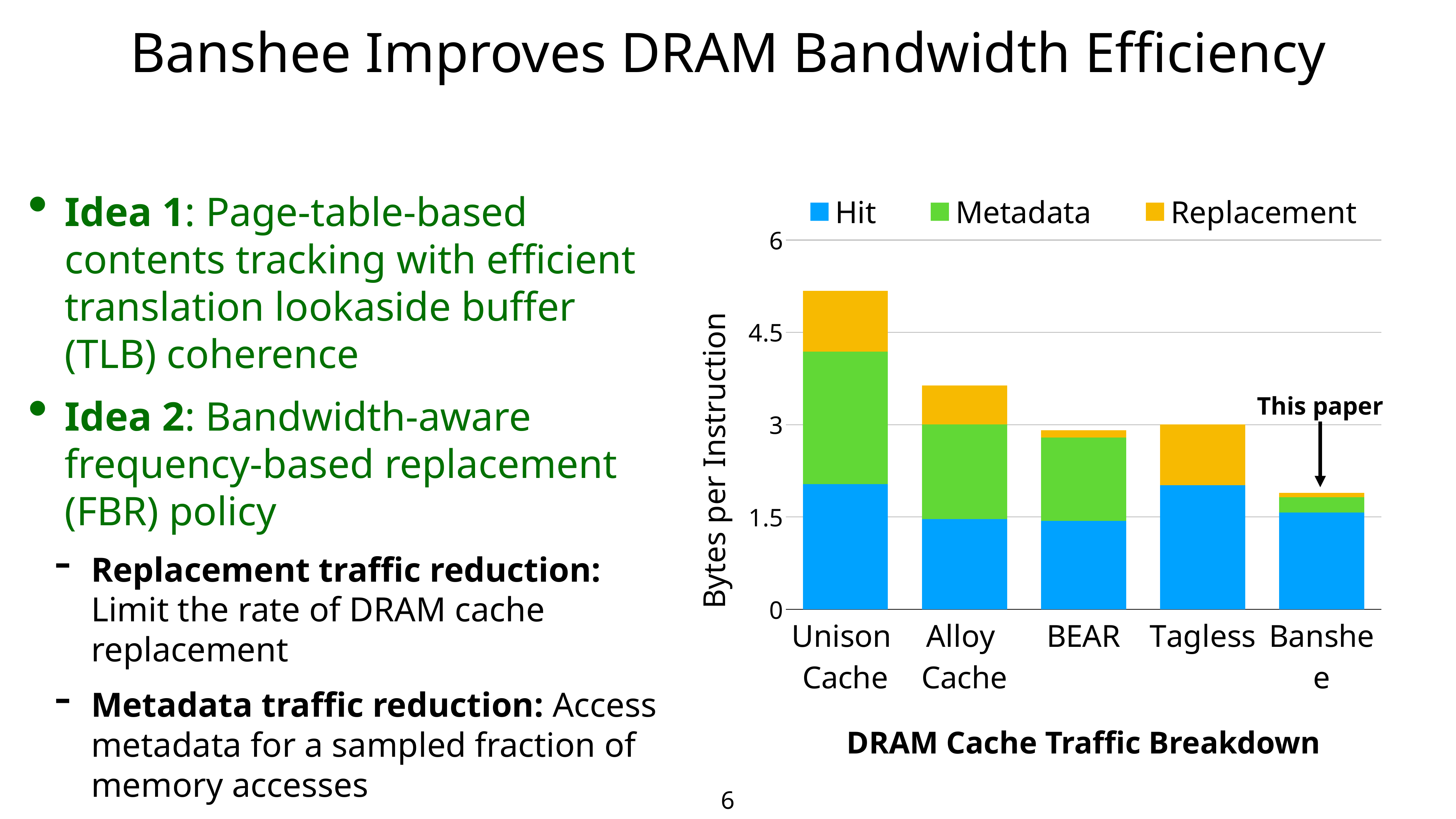
Which cache design has the lowest total bytes per instruction? Banshee Which has a larger total bytes per instruction, Unison Cache or Alloy Cache? Unison Cache How many cache designs (categories) are shown on the x axis of the chart? 5 How many series does the chart legend list? 3 Is the total bytes per instruction for Unison Cache greater or less than 4.5? greater What is the title of the chart? DRAM Cache Traffic Breakdown Which bar is annotated with the label "This paper"? Banshee Is the total bytes per instruction for Banshee greater or less than 3? less What kind of chart is shown on the slide? Stacked bar chart Is the total bytes per instruction for Alloy Cache greater or less than 3? greater Do the total bar heights generally rise or fall from Unison Cache to Banshee along the x axis? fall Which cache design has the highest total bytes per instruction? Unison Cache